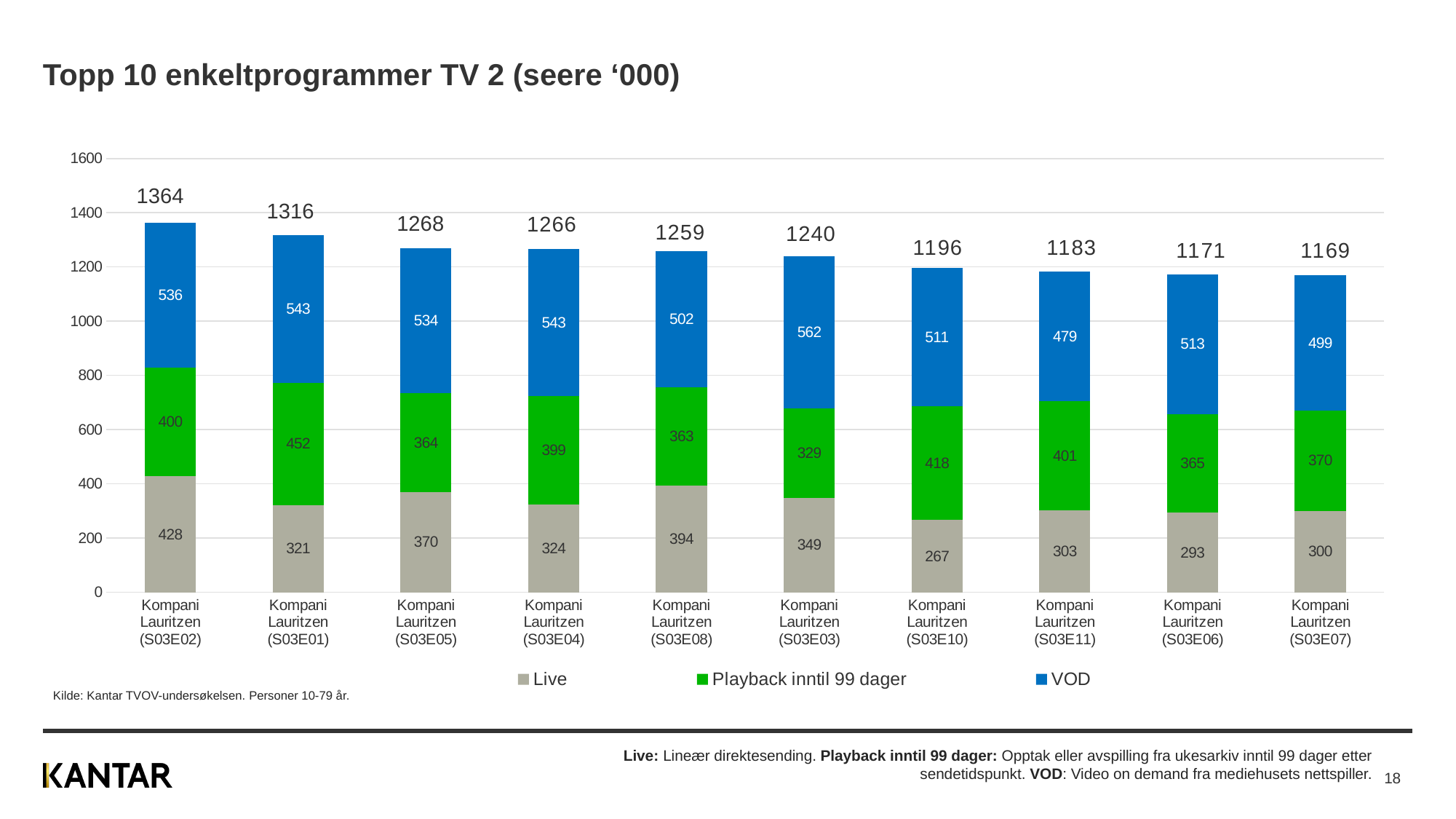
Which episode has the highest total? Kompani Lauritzen (S03E02) How many episodes are shown on the chart? 10 How many series does the legend list? 3 Which is larger, the VOD value for Kompani Lauritzen (S03E11) or for Kompani Lauritzen (S03E06)? Kompani Lauritzen (S03E06) What is the difference between the totals of Kompani Lauritzen (S03E02) and Kompani Lauritzen (S03E07)? 195 What kind of chart is shown? Stacked bar chart What is the VOD value for Kompani Lauritzen (S03E03)? 562 Which series is shown in blue? VOD What is the total for the Kompani Lauritzen (S03E01) bar? 1316 What is the Playback inntil 99 dager value for Kompani Lauritzen (S03E10)? 418 What is the Live value for Kompani Lauritzen (S03E02)? 428 Which episode has the lowest Live value? Kompani Lauritzen (S03E10)